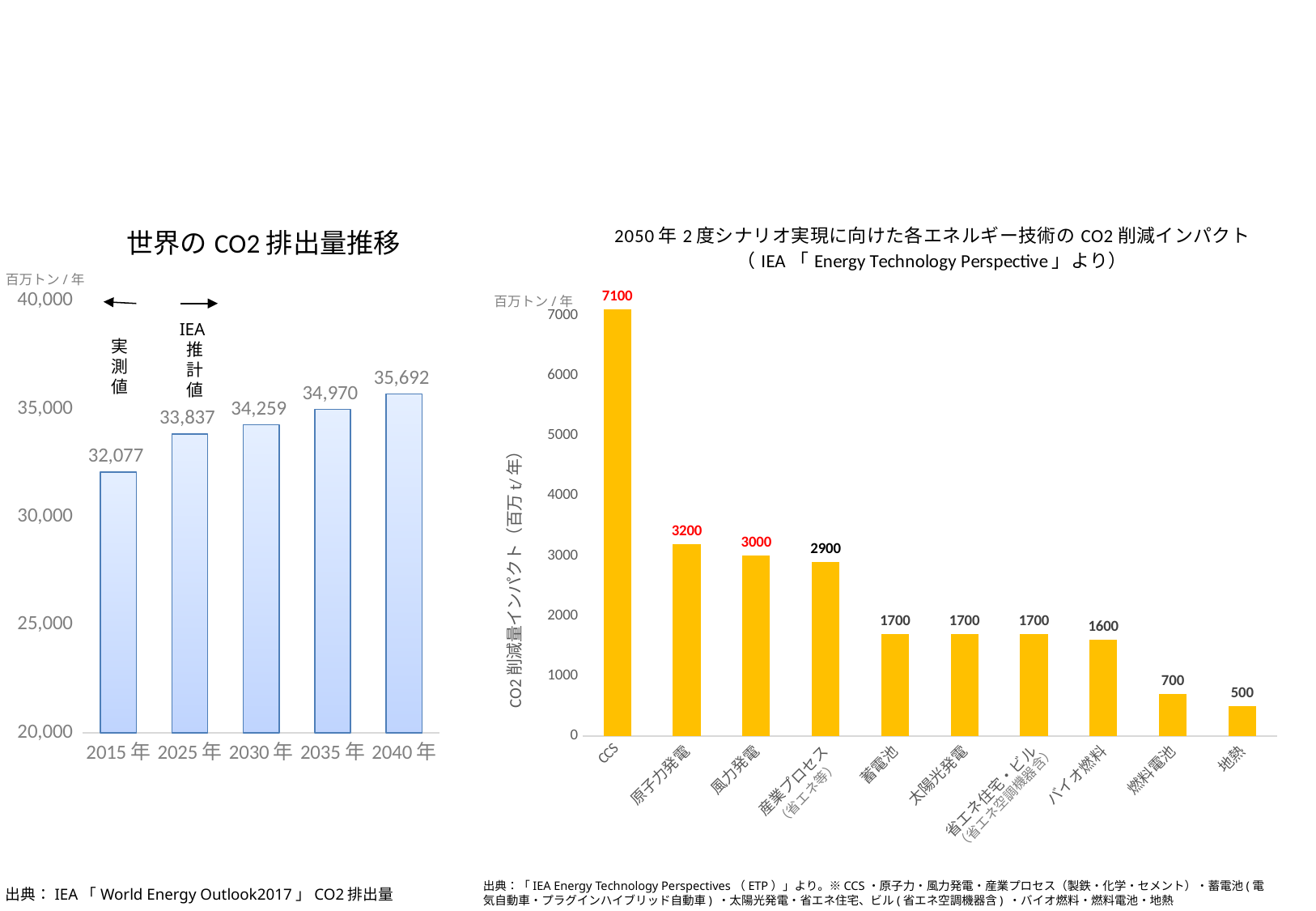
In the left chart titled 世界のCO2排出量推移, what is the difference between the values for 2040年 and 2015年? 3,615 In the right chart about CO2削減インパクト, which category has the highest value? CCS In the right chart about CO2削減インパクト, which is larger, the value for バイオ燃料 or the value for 燃料電池? バイオ燃料 In the left chart titled 世界のCO2排出量推移, which year has the lowest value? 2015年 In the left chart titled 世界のCO2排出量推移, do the values rise or fall from 2015年 to 2040年? rise What kind of chart is the right chart about CO2削減インパクト? bar chart In the left chart titled 世界のCO2排出量推移, what is the value for 2040年? 35,692 In the right chart about CO2削減インパクト, what is the difference between the values for 原子力発電 and 風力発電? 200 In the right chart about CO2削減インパクト, what is the value for CCS? 7100 In the left chart titled 世界のCO2排出量推移, what is the value for 2015年? 32,077 In the right chart about CO2削減インパクト, what is the value for 地熱? 500 In the left chart titled 世界のCO2排出量推移, how many years are plotted? 5